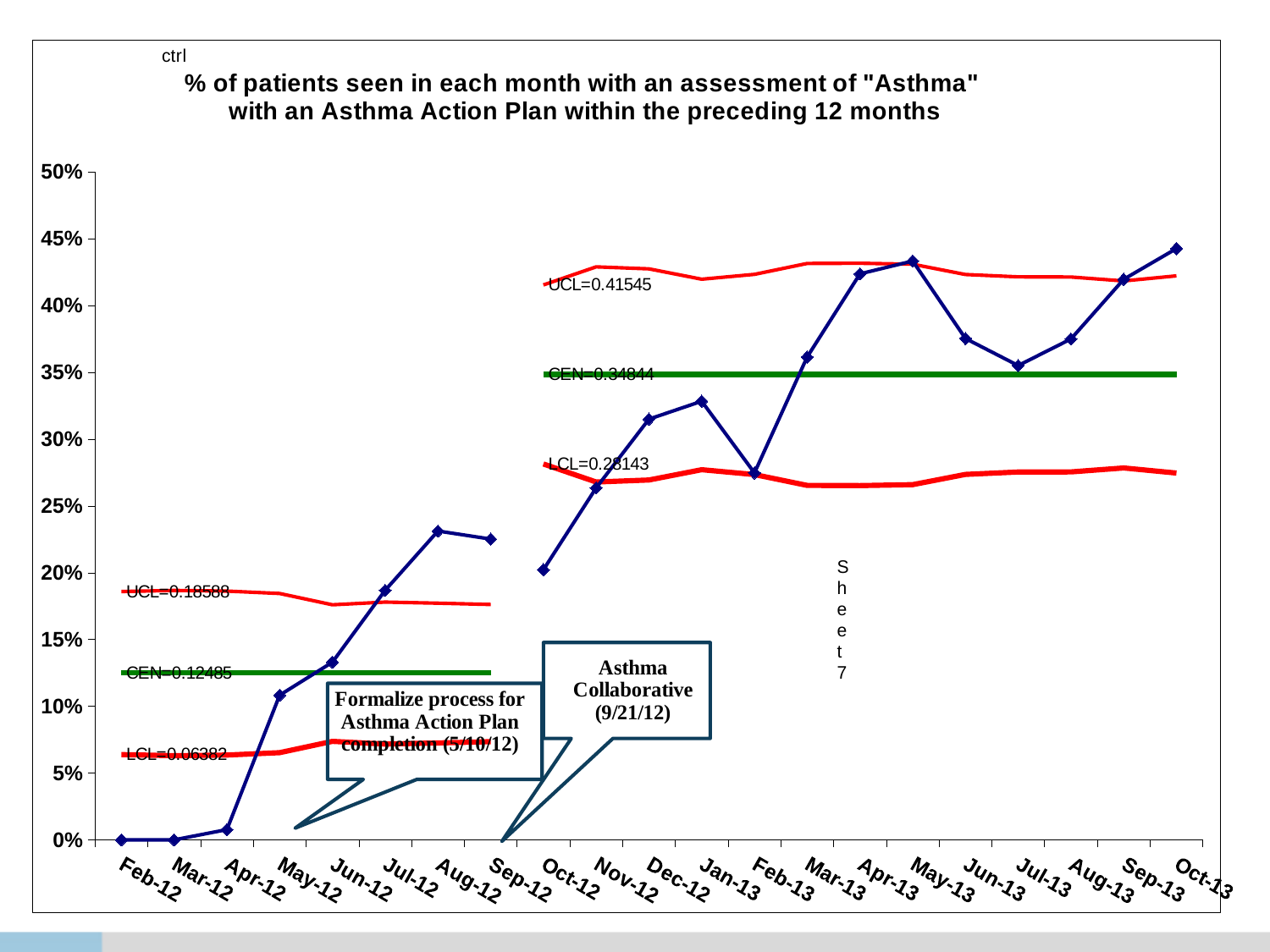
Which month has the highest plotted value? Oct-13 What is the plotted value for Feb-12? 0% Which is larger, the value for Dec-12 or the value for Feb-13? Dec-12 What is the LCL value printed for the second phase of the chart? 0.28143 Do the plotted values rise or fall from Feb-12 to Aug-12? rise Is the value for Oct-12 greater or less than 25%? less What is the UCL value printed for the second phase of the chart (from Oct-12 onward)? 0.41545 Is the value for Oct-13 greater or less than 40%? greater What is the CEN value printed for the first phase of the chart (Feb-12 to Aug-12)? 0.12485 What kind of chart is shown on the slide? line chart What date is given in the 'Asthma Collaborative' annotation? 9/21/12 How many months are plotted along the x axis? 21